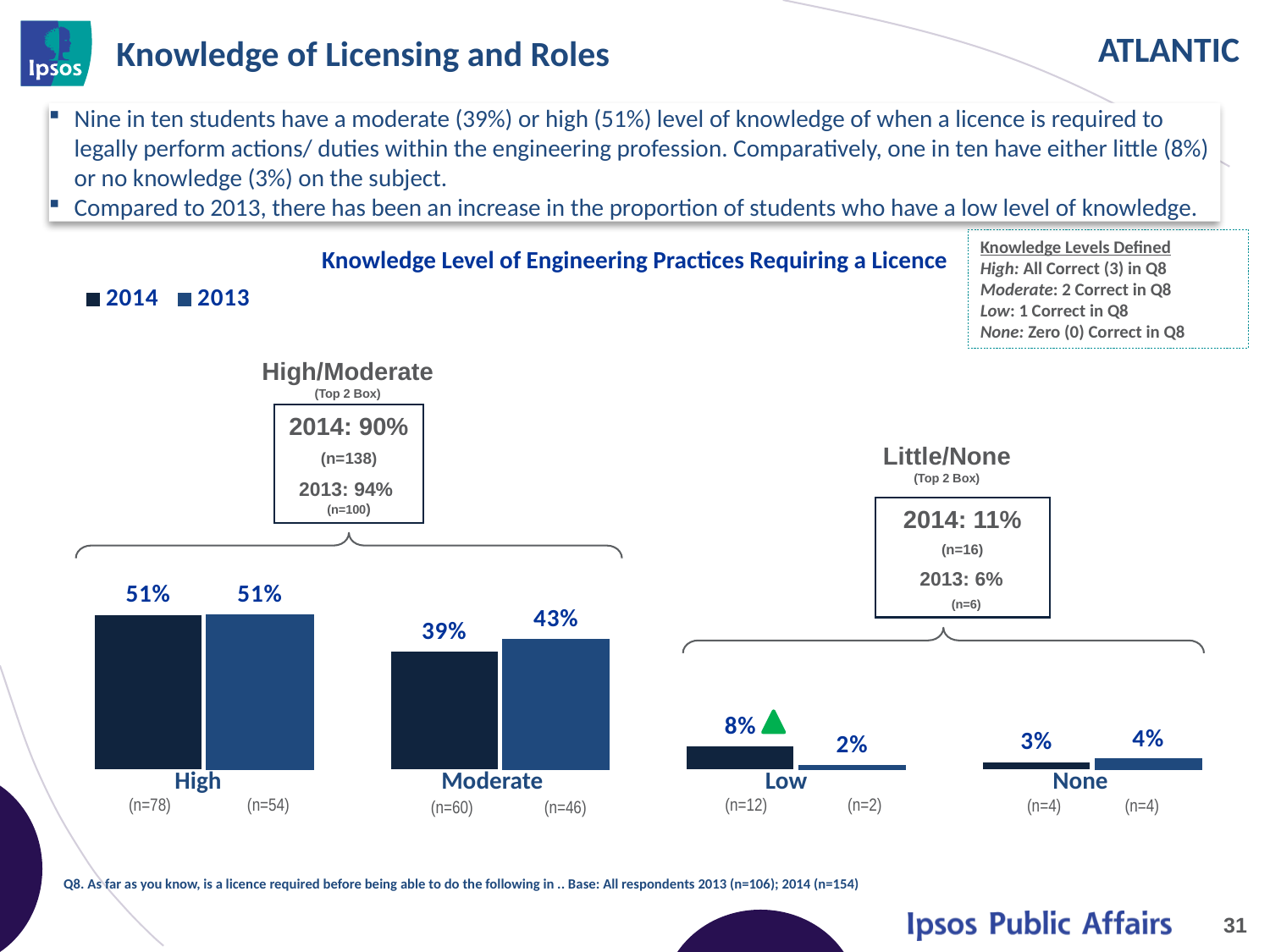
Which category has the lowest 2013 value? Low What is the 2014 value for Moderate? 39% Which is larger for Low: the 2014 value or the 2013 value? 2014 What kind of chart is shown? Bar chart What is the 2014 value for None? 3% How many categories are shown on the x axis? 4 What is the 2013 value for Low? 2% Which category has the highest 2014 value? High What is the difference between the 2013 and 2014 values for Moderate? 4% What is the title of the chart? Knowledge Level of Engineering Practices Requiring a Licence How many series does the legend list? 2 What is the 2014 High/Moderate (Top 2 Box) value shown in the box above the chart? 90%